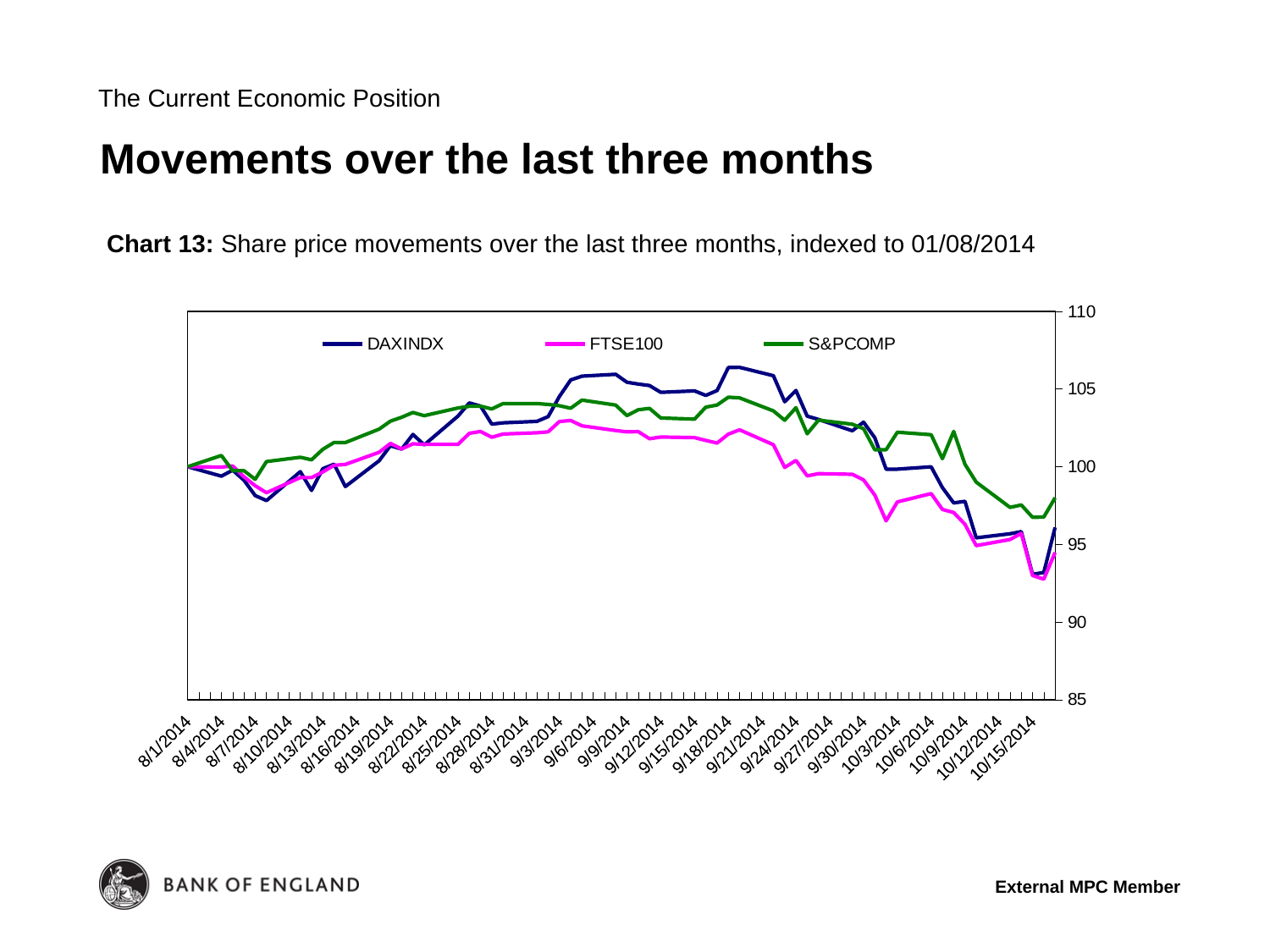
Which three series are shown in the legend of Chart 13? DAXINDX, FTSE100, S&PCOMP Is the value of FTSE100 at 10/3/2014 greater or less than 100? less Which series reaches the highest value in Chart 13? DAXINDX Does DAXINDX rise or fall between 9/21/2014 and 10/12/2014? fall At 9/18/2014, which is higher, DAXINDX or FTSE100? DAXINDX Is the value of FTSE100 at 10/15/2014 greater or less than 95? less Is the value of S&PCOMP at 9/3/2014 greater or less than 100? greater At 10/15/2014, which series has the highest value in Chart 13? S&PCOMP What kind of chart is Chart 13? line chart How many series does the legend of Chart 13 list? 3 What is the value of all three series at 8/1/2014 in Chart 13? 100